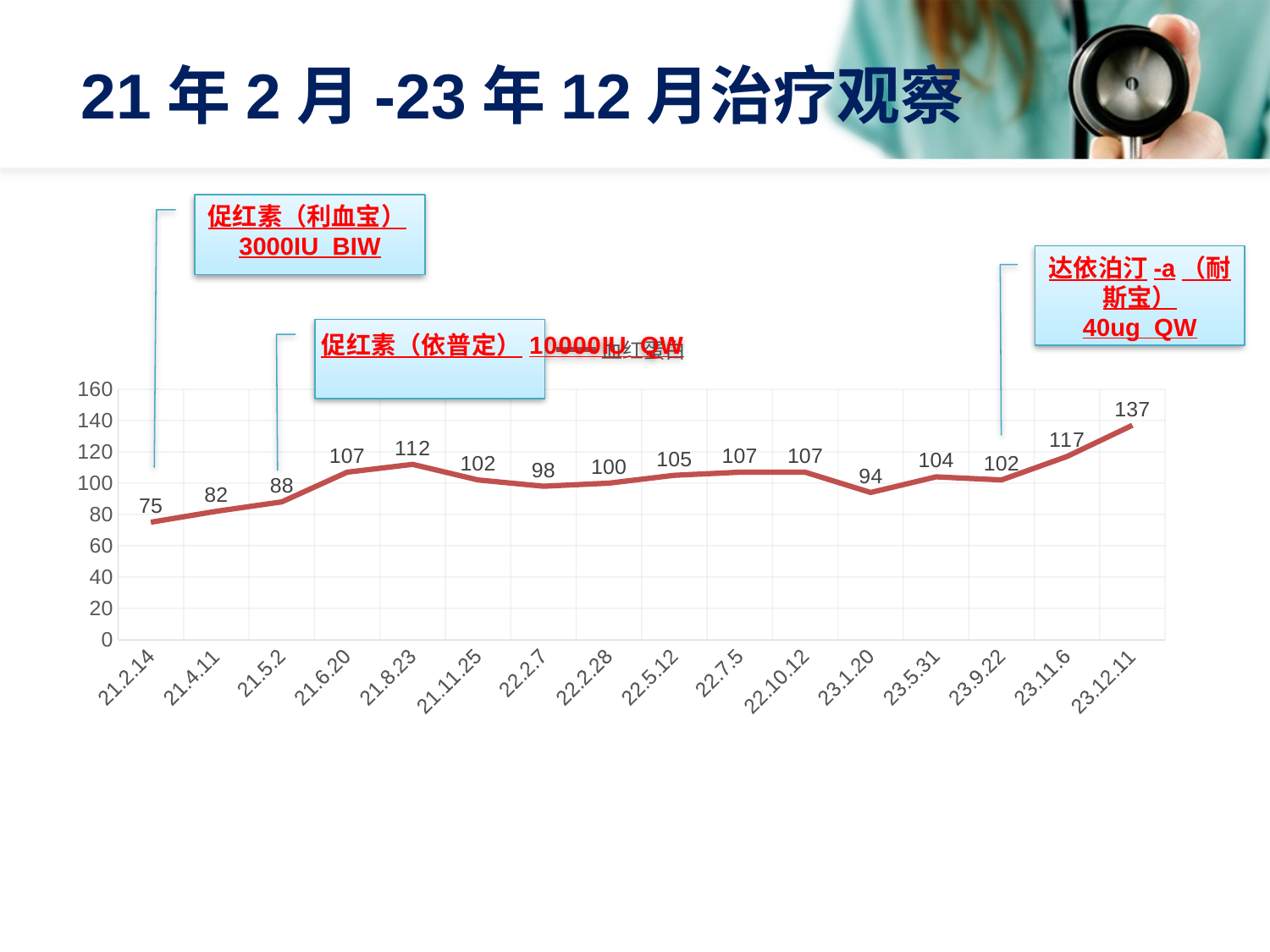
What kind of chart is shown on the slide? line chart How many data points are plotted on the line? 16 Which date has the highest plotted value? 23.12.11 What is the value plotted for 21.2.14? 75 Which date has the lowest plotted value? 21.2.14 What is the value plotted for 23.12.11? 137 What is the difference between the values for 23.11.6 and 23.9.22? 15 What is the value plotted for 21.8.23? 112 Which is larger, the value for 21.8.23 or the value for 23.1.20? 21.8.23 What is the value plotted for 23.1.20? 94 Do the values rise or fall from 23.9.22 to 23.12.11? rise What is the difference between the values for 23.12.11 and 21.2.14? 62